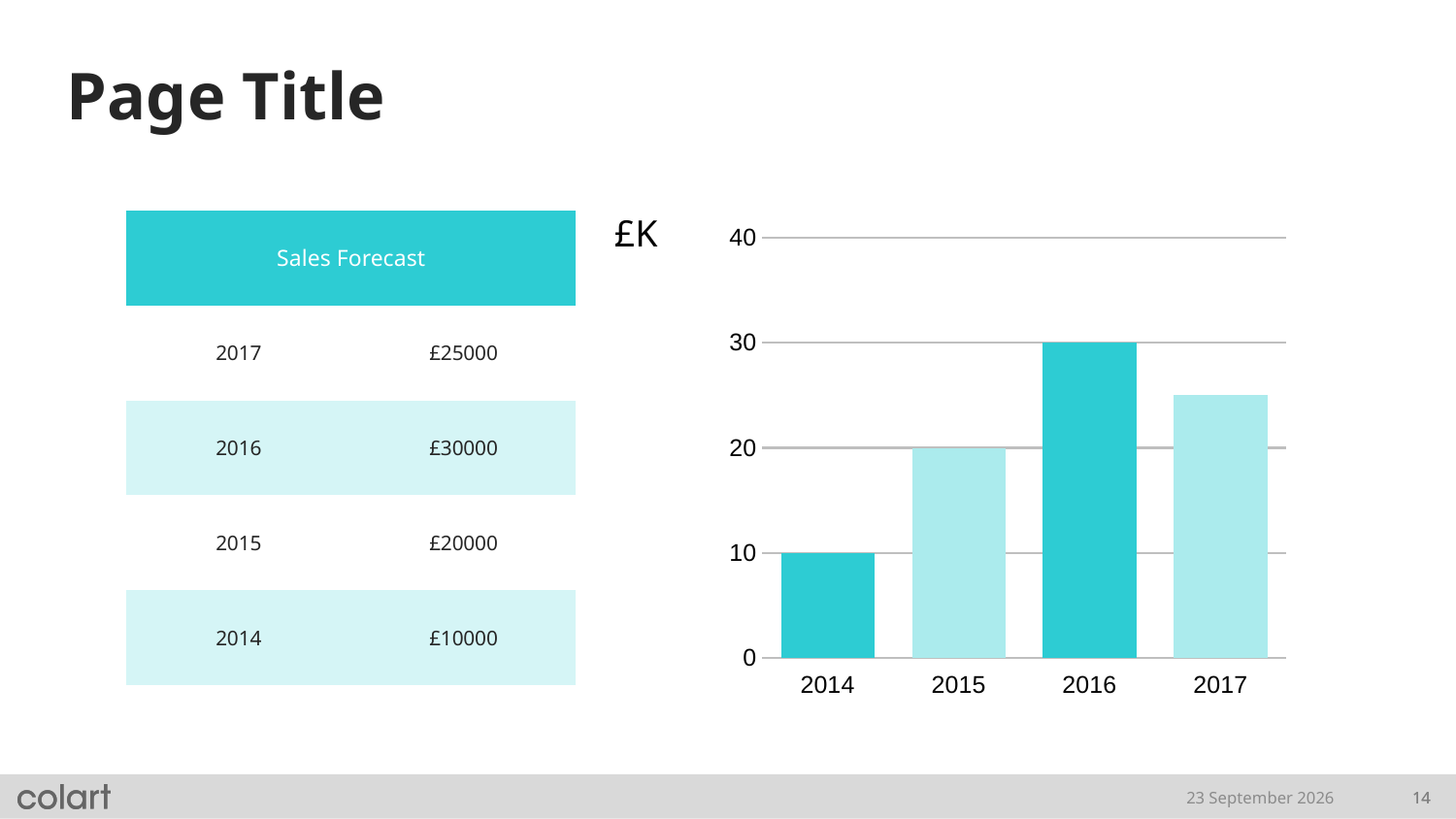
Which year has the highest bar in the chart? 2016 What is the value for 2014 in the bar chart? 10 Is the value for 2017 in the bar chart greater or less than 20? greater How many years are shown on the x axis of the bar chart? 4 What is the difference between the values for 2016 and 2014 in the bar chart? 20 Which year has the lowest bar in the chart? 2014 What kind of chart is shown on the slide? bar chart Which is larger in the bar chart, the value for 2015 or the value for 2014? 2015 What unit label is shown next to the top of the chart's y axis? £K What is the value for 2016 in the bar chart? 30 What is the value for 2015 in the bar chart? 20 Is the value for 2017 in the bar chart greater or less than 30? less